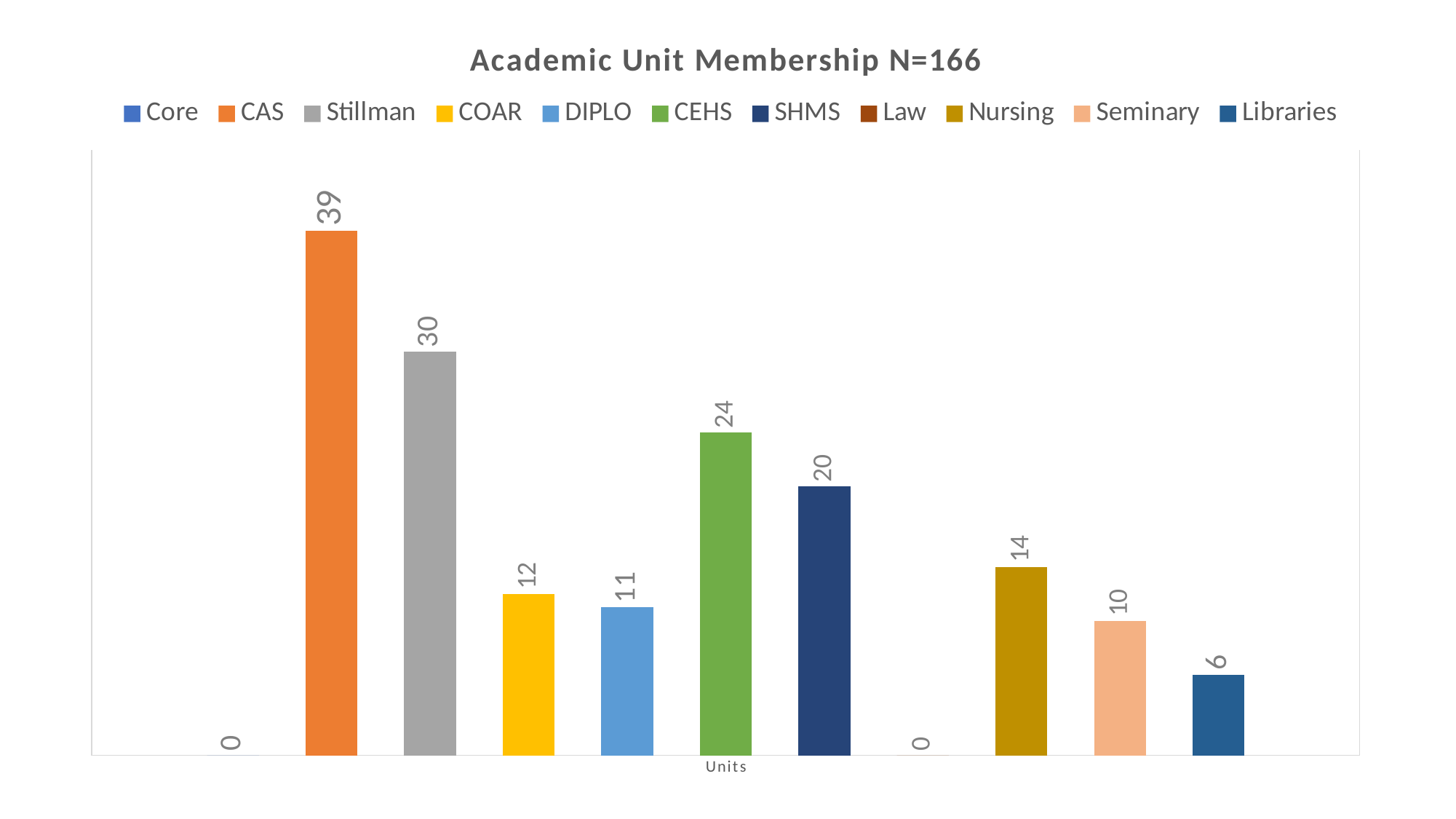
What is the value for CEHS? 24 What is the value for Stillman? 30 What kind of chart is shown? Bar chart What is the value for Libraries? 6 What is the value for CAS? 39 What is the title of the chart? Academic Unit Membership N=166 What is the difference between the values for SHMS and Nursing? 6 Which unit has the highest membership? CAS What is the difference between the values for CAS and Stillman? 9 Which is larger, the value for COAR or the value for DIPLO? COAR Which is larger, the value for Seminary or the value for Nursing? Nursing How many series does the legend list? 11